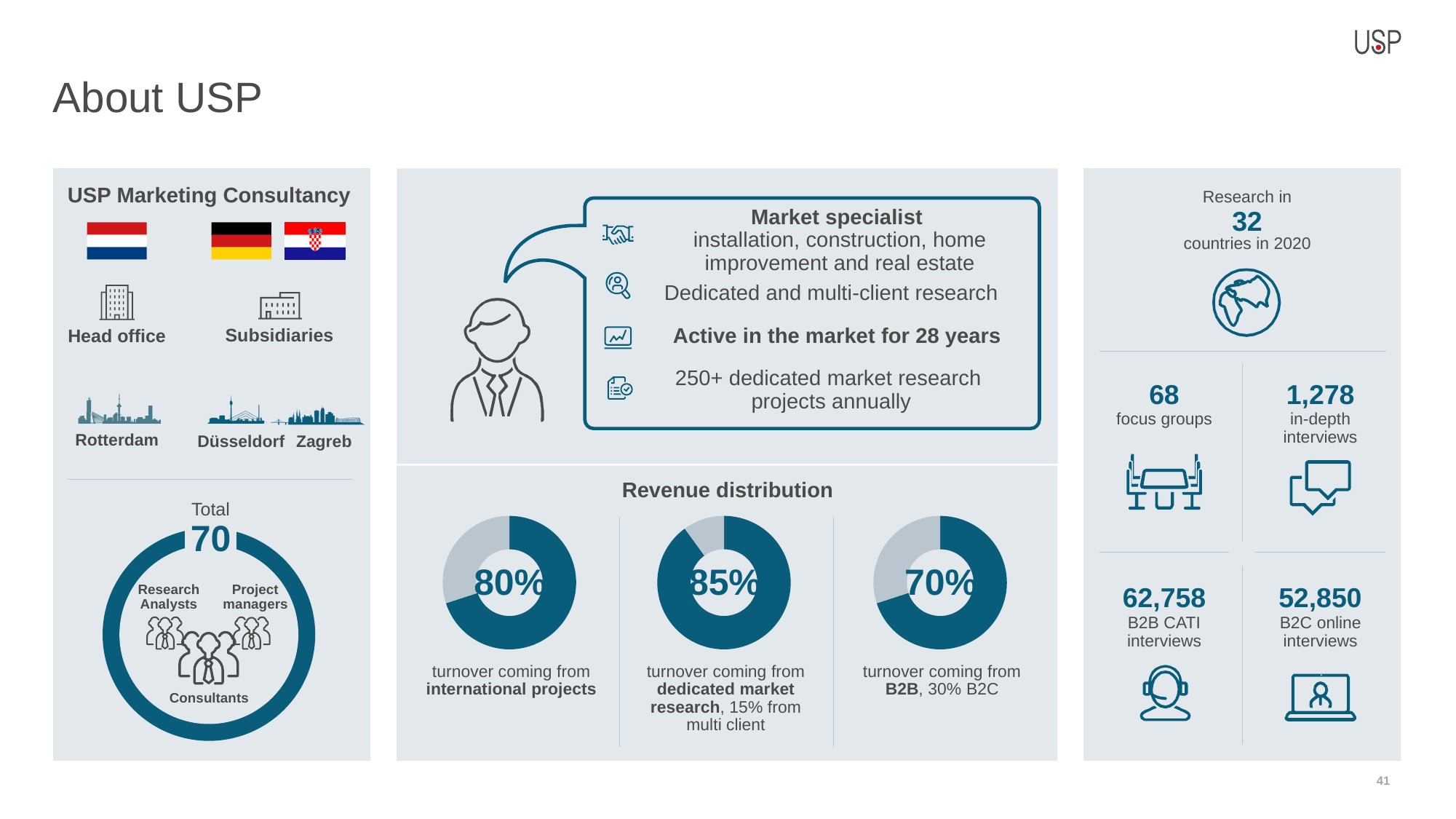
In the Revenue distribution section, what share of turnover comes from international projects? 80% In the Revenue distribution section, what share of turnover comes from B2C? 30% How many donut charts are shown in the Revenue distribution section? 3 In the Revenue distribution section, which is larger: the share from international projects or the share from B2B? international projects Which of the three Revenue distribution donut charts shows the highest percentage? dedicated market research (85%) In the Revenue distribution section, what share of turnover comes from multi client research? 15% What type of chart is used to show the Revenue distribution figures? donut (pie) chart What is the title of the section containing the three donut charts? Revenue distribution Which of the three Revenue distribution donut charts shows the lowest percentage? B2B (70%) In the Revenue distribution section, what is the difference between the share from dedicated market research and the share from B2B? 15 percentage points In the Revenue distribution section, what share of turnover comes from B2B? 70% In the Revenue distribution section, what share of turnover comes from dedicated market research? 85%